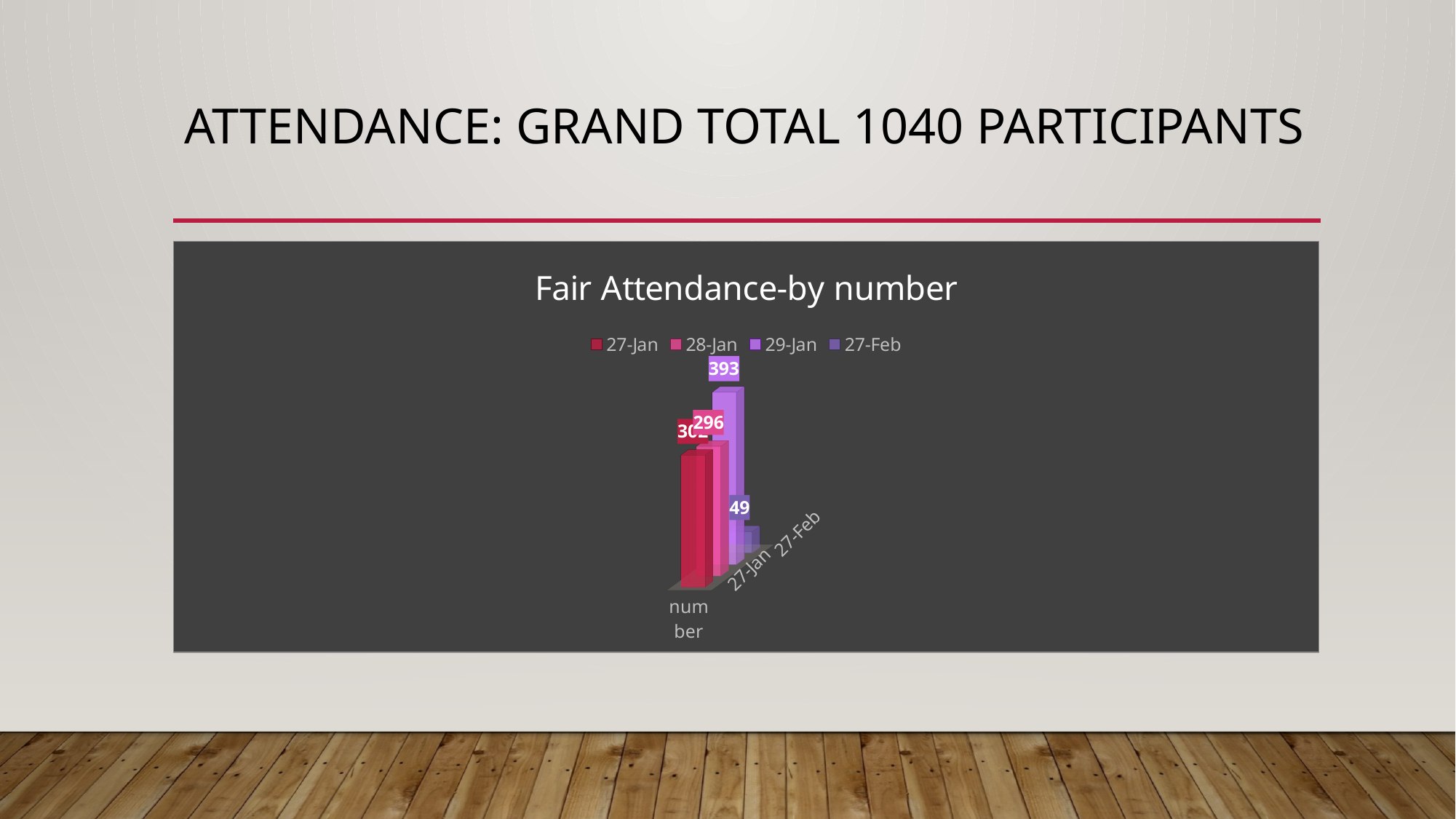
What is the value for 29-Jan? 393 Which date has the lowest attendance? 27-Feb How many series does the chart legend list? 4 What is the difference between the values for 28-Jan and 27-Feb? 247 Which is larger, the value for 28-Jan or the value for 29-Jan? 29-Jan Which date has the highest attendance? 29-Jan What is the difference between the values for 29-Jan and 28-Jan? 97 What is the value for 28-Jan? 296 What kind of chart is shown on the slide? bar chart Which series is listed first in the legend? 27-Jan What is the title of the chart? Fair Attendance-by number What is the value for 27-Feb? 49